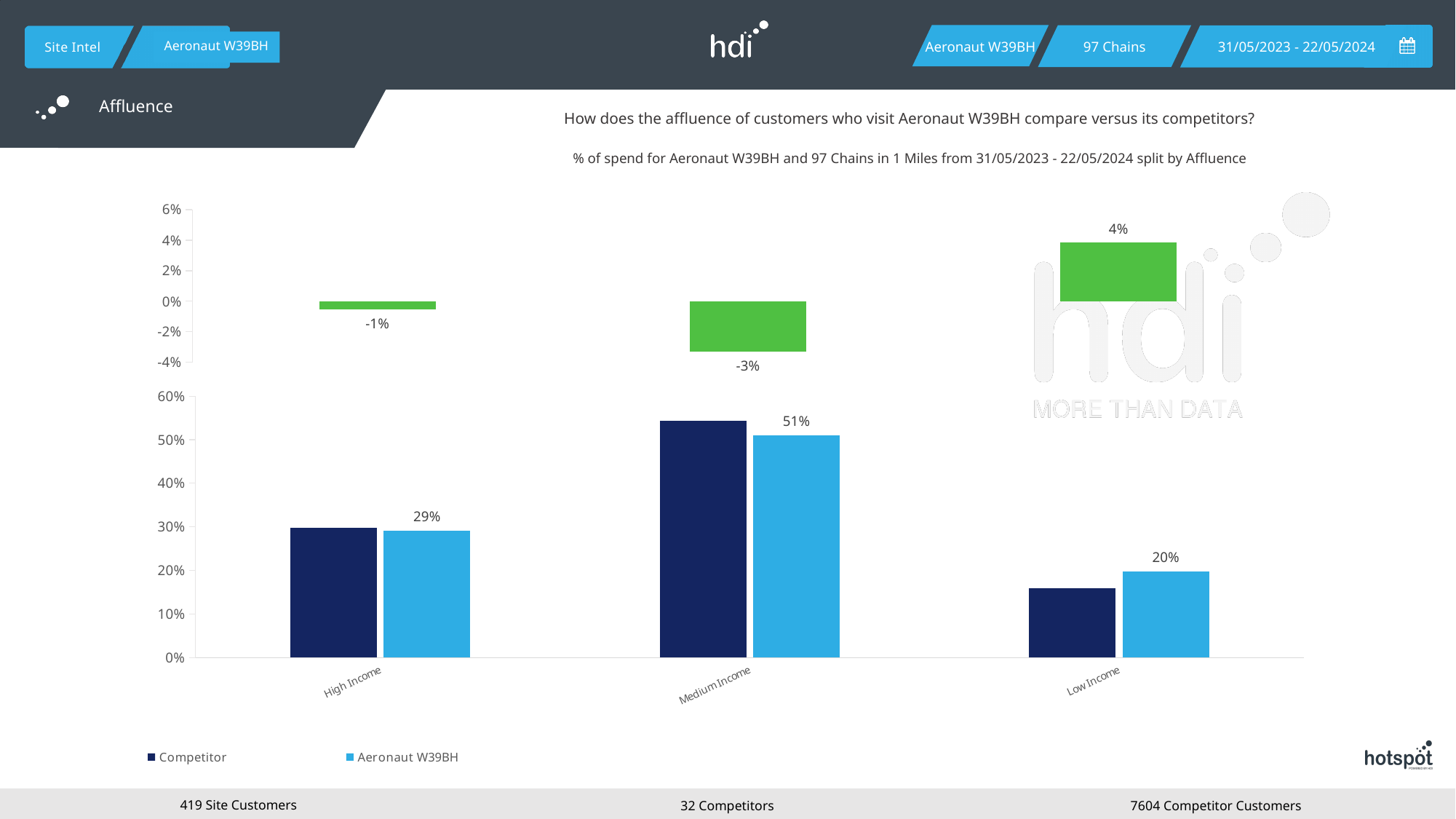
In the top difference chart, what is the value shown for Low Income? 4% In the bottom bar chart, is the Competitor value for Medium Income greater or less than 50%? greater In the top difference chart, what is the value shown for Medium Income? -3% In the bottom bar chart, is the Competitor value for Low Income greater or less than 20%? less In the bottom bar chart, which category has the highest Aeronaut W39BH value? Medium Income In the bottom bar chart, what is the value for Aeronaut W39BH in the Low Income category? 20% In the top difference chart, which category has the highest value? Low Income In the bottom bar chart, what is the value for Aeronaut W39BH in the Medium Income category? 51% In the bottom bar chart, which category has the lowest Aeronaut W39BH value? Low Income In the bottom bar chart, what is the value for Aeronaut W39BH in the High Income category? 29% In the bottom bar chart, what is the difference between the Aeronaut W39BH values for Medium Income and High Income? 22% How many series does the legend of the bottom bar chart list? 2